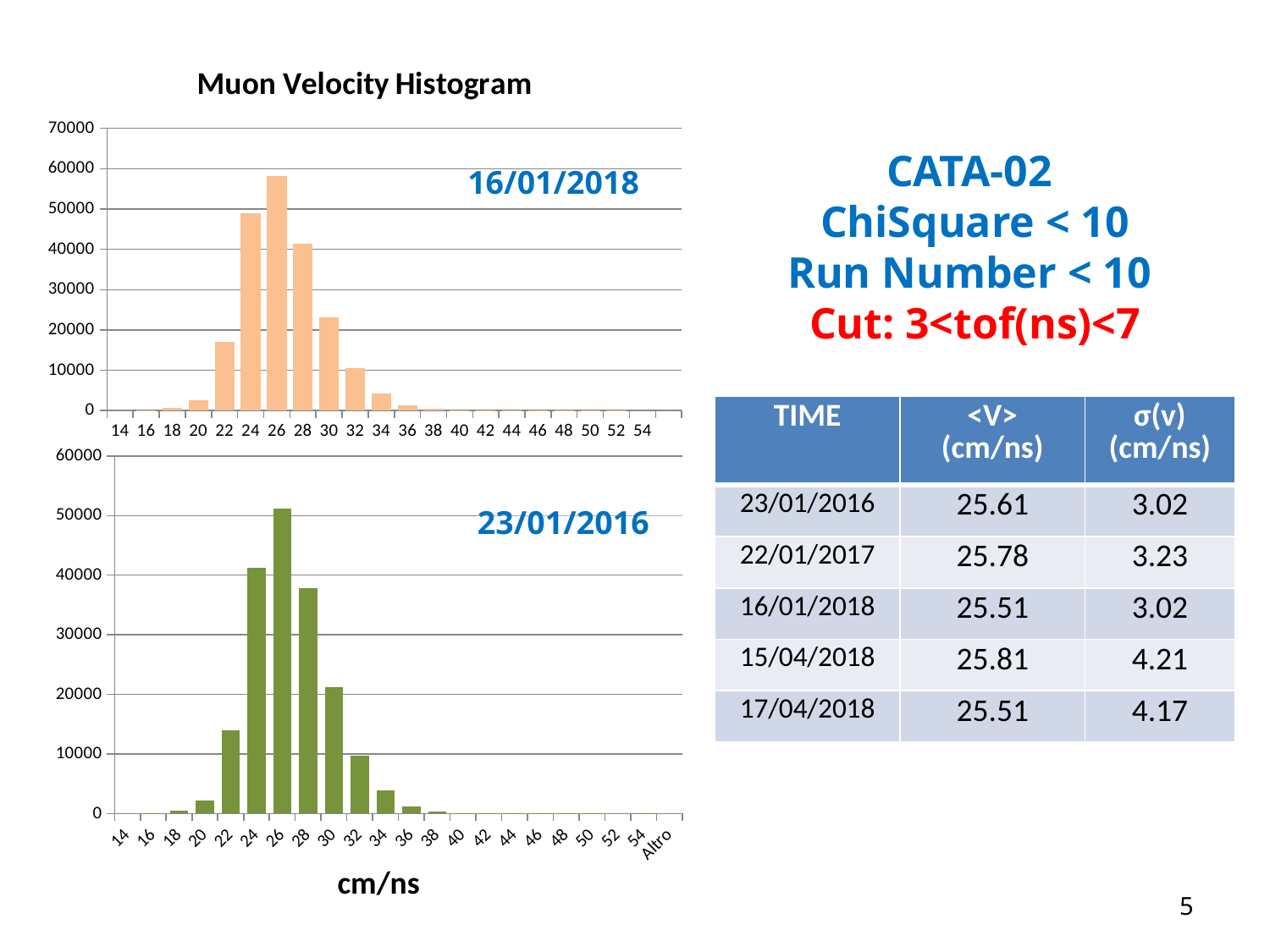
In the bottom chart (23/01/2016), is the value for bin 28 greater or less than 40000? less What is the x-axis unit label shown under the bottom chart? cm/ns What kind of chart is the top chart titled "Muon Velocity Histogram"? bar chart In the top chart (16/01/2018), which bin has the larger count, 24 or 28? 24 In the bottom chart (23/01/2016), which velocity bin has the highest count? 26 In the top chart (16/01/2018), is the value for bin 22 greater or less than 20000? less In the top chart (16/01/2018), which velocity bin has the highest count? 26 In the bottom chart (23/01/2016), which bin has the larger count, 22 or 30? 30 In the bottom chart (23/01/2016), is the value for bin 22 greater or less than 10000? greater How many velocity bins are labelled on the x axis of the top chart (16/01/2018)? 21